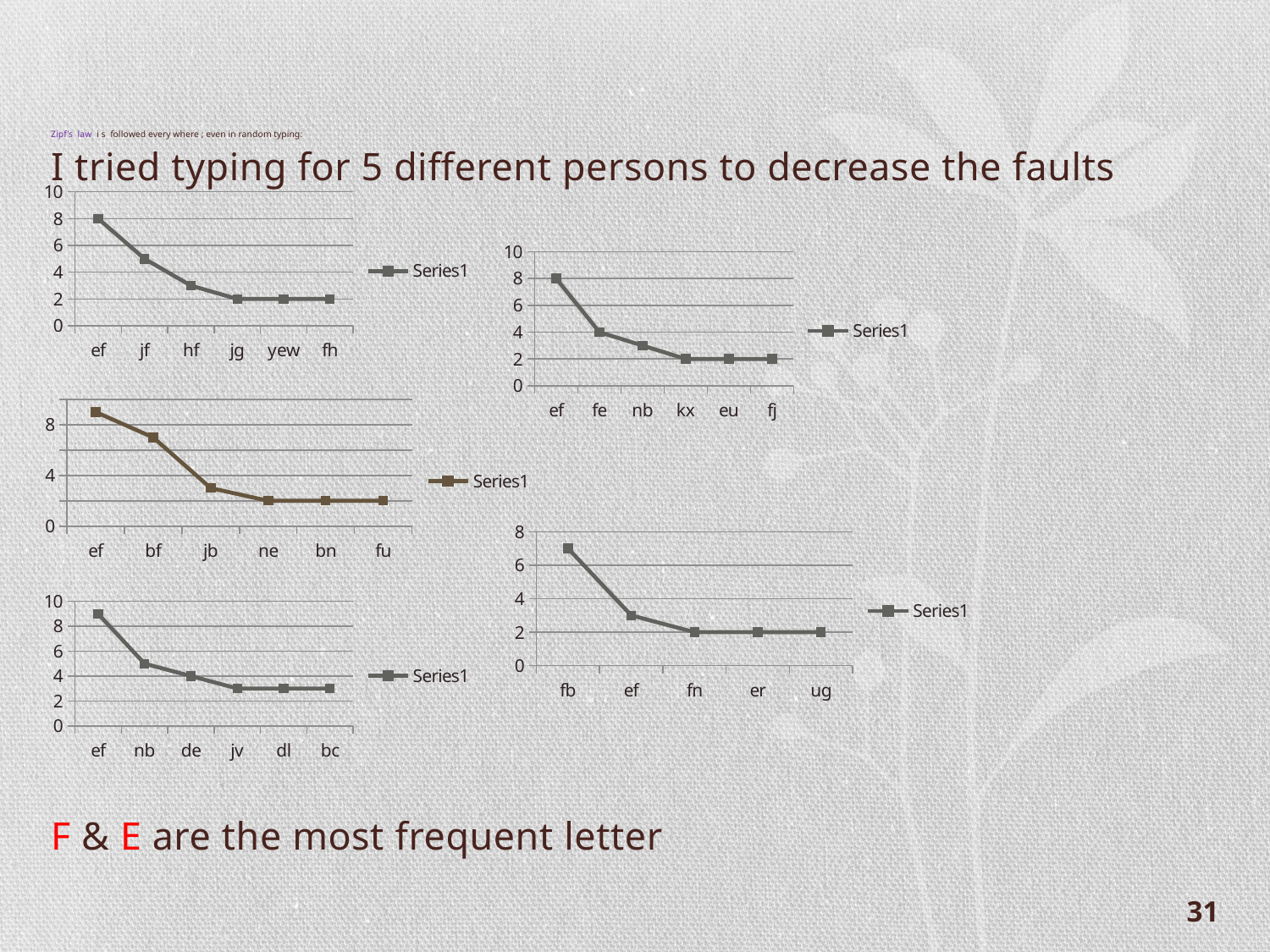
How many charts are shown on the slide? 5 How many series does the legend of the bottom-right chart (categories fb, ef, fn, er, ug) list? 1 In the middle-left chart (categories ef, bf, jb, ne, bn, fu), is the value for ef greater or less than 8? greater In the bottom-left chart (categories ef, nb, de, jv, dl, bc), what is the value for de? 4 In the bottom-left chart (categories ef, nb, de, jv, dl, bc), do the values rise or fall from ef to jv? fall In the top-left chart (categories ef, jf, hf, jg, yew, fh), what is the value for ef? 8 In the top-left chart (categories ef, jf, hf, jg, yew, fh), which category has the highest value? ef In the bottom-right chart (categories fb, ef, fn, er, ug), which category has the highest value? fb In the top-right chart (categories ef, fe, nb, kx, eu, fj), what is the value for fe? 4 In the top-right chart (categories ef, fe, nb, kx, eu, fj), what is the difference between the values for ef and fe? 4 What type of chart is the top-left chart (categories ef, jf, hf, jg, yew, fh)? line chart In the middle-left chart (categories ef, bf, jb, ne, bn, fu), how many categories are on the x axis? 6